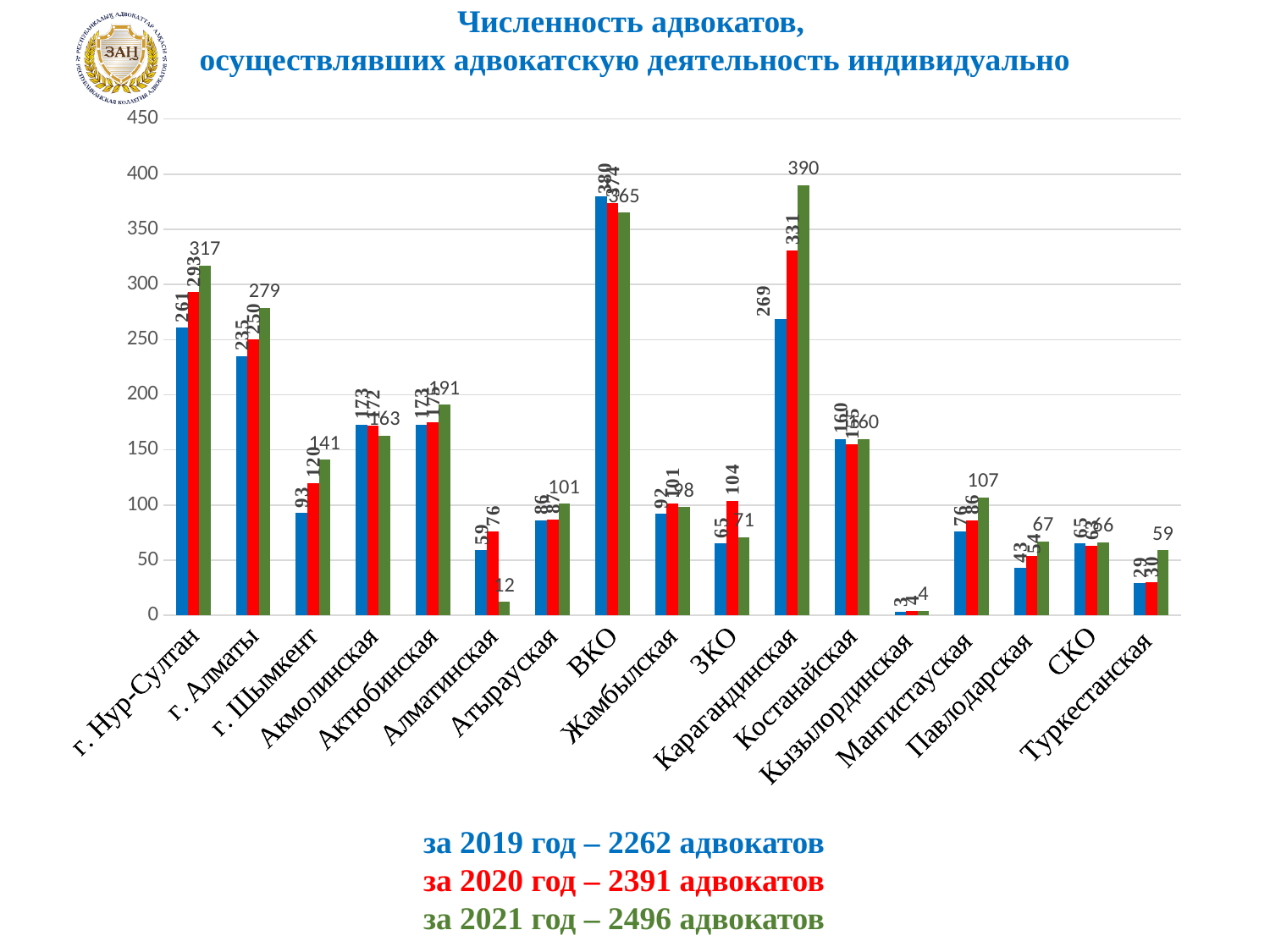
What is the 2021 value for Карагандинская? 390 Which region has the lowest 2021 value? Кызылординская What is the 2019 value for г. Нур-Султан? 261 Which region has the highest 2021 value? Карагандинская What kind of chart is shown on the slide? bar chart By how much did the value for г. Нур-Султан increase from 2019 (261) to 2021 (317)? 56 How many regions (categories) are shown on the x axis of the chart? 17 Do the values for г. Шымкент rise or fall from 2019 to 2021? rise What is the 2021 value for Мангистауская? 107 Which is larger in 2021: Карагандинская or ВКО? Карагандинская How many data series (years) does the chart plot for each region? 3 Is the 2019 value for ВКО greater or less than 350? greater